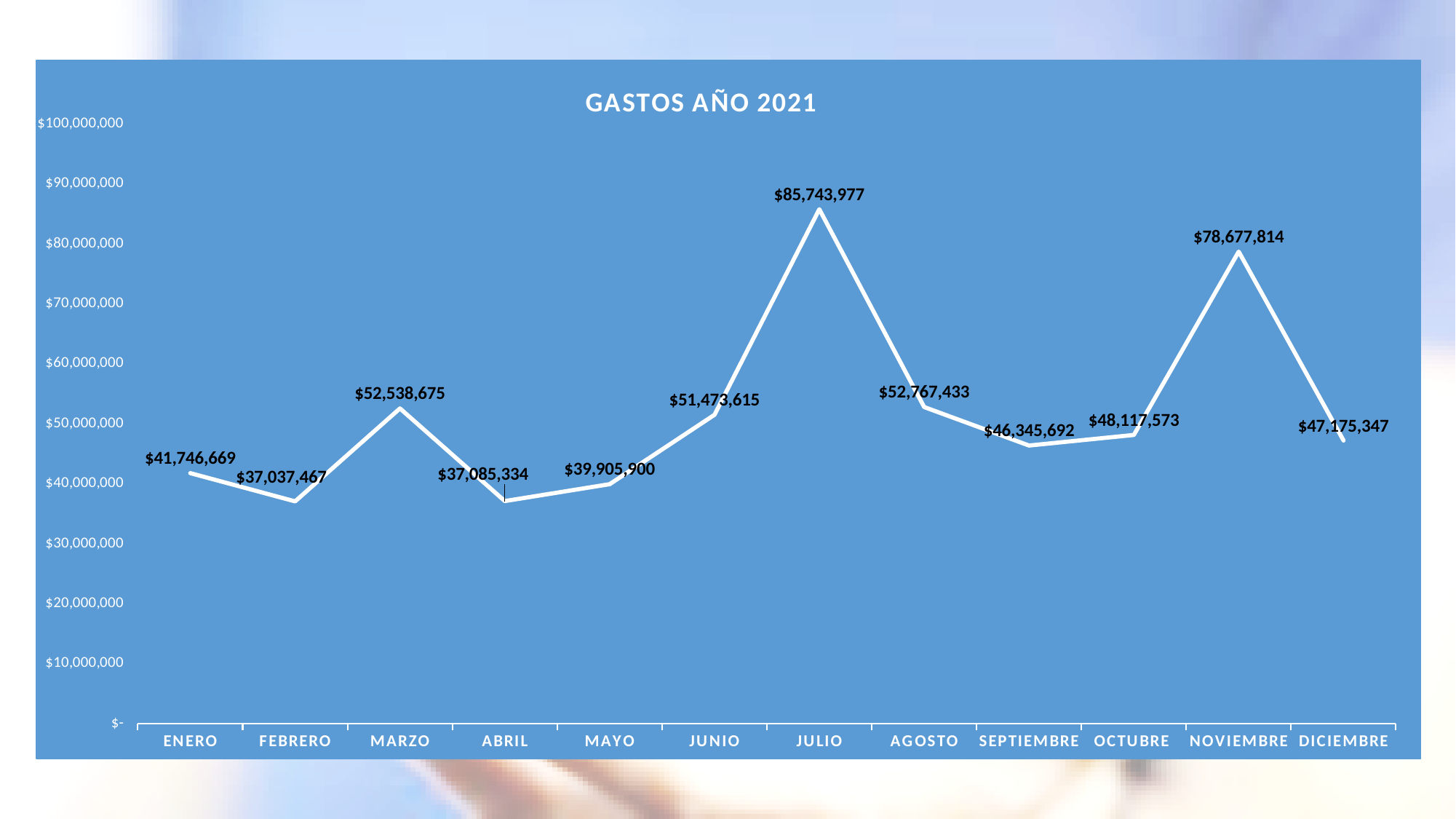
What kind of chart is shown on the slide? line chart What is the value for DICIEMBRE? $47,175,347 What is the difference between the values for JULIO and NOVIEMBRE? $7,066,163 What is the value for JULIO? $85,743,977 How many months are plotted on the chart? 12 What is the value for NOVIEMBRE? $78,677,814 What is the difference between the values for MARZO and ENERO? $10,792,006 Which is larger, the value for JUNIO or the value for OCTUBRE? JUNIO Is the value for SEPTIEMBRE greater or less than $50,000,000? less What is the value for ENERO? $41,746,669 Which month has the highest value? JULIO Which month has the lowest value? FEBRERO